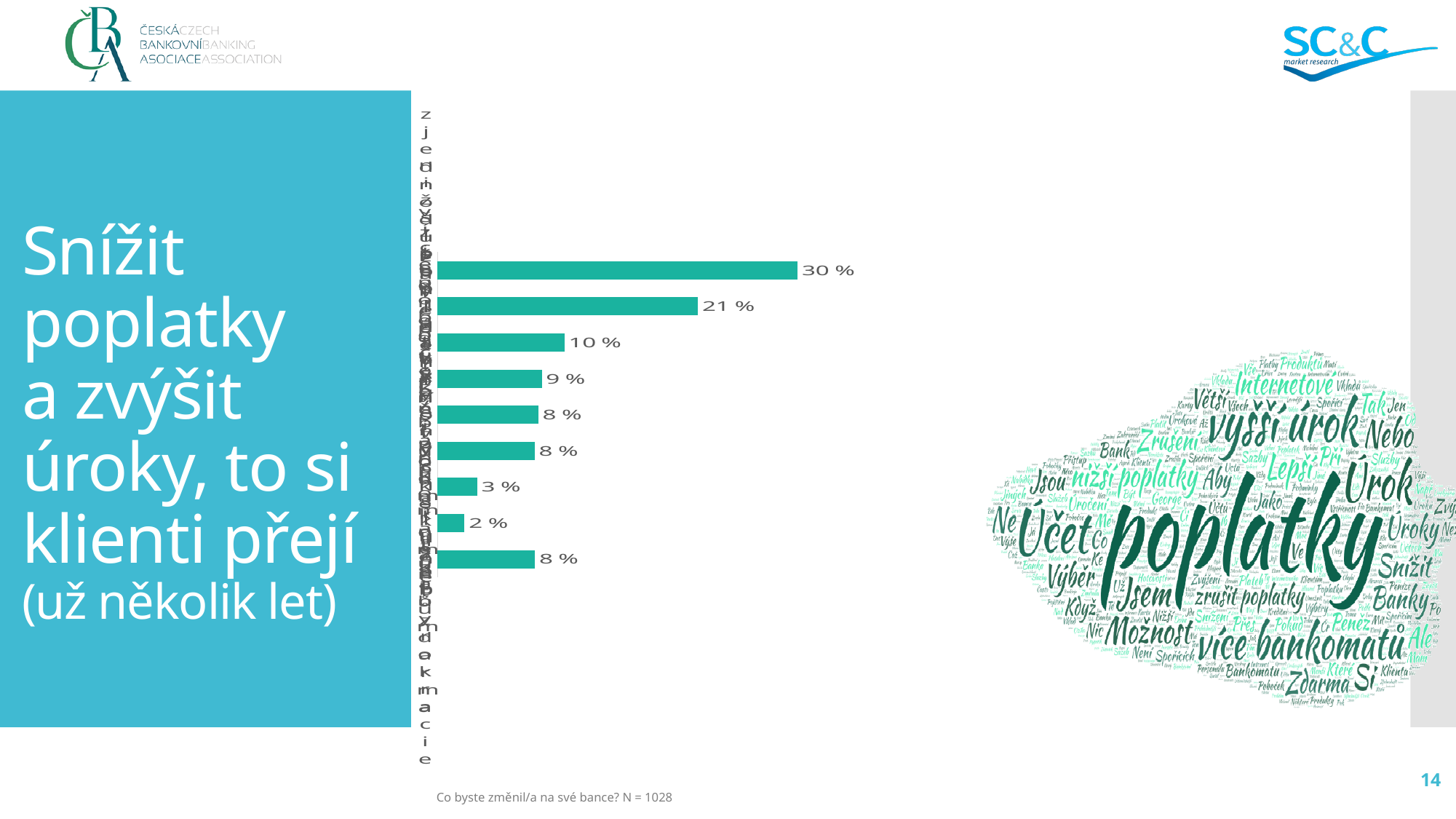
What is the value of the bottom bar in the chart? 8 % Which is larger: the fourth bar from the top or the seventh bar from the top? the fourth bar from the top (9 %) What is the difference between the top bar (30 %) and the second bar (21 %)? 9 % What is the value of the third bar from the top in the chart? 10 % What is the lowest value shown in the chart? 2 % What kind of chart is shown on the slide? bar chart What is the value of the second bar from the top in the chart? 21 % How many bars does the chart contain? 9 What is the value of the topmost bar in the chart? 30 % What is the highest value shown in the chart? 30 % How many bars in the chart have a value of 8 %? 3 What survey question and sample size are given in the note below the chart? Co byste změnil/a na své bance? N = 1028